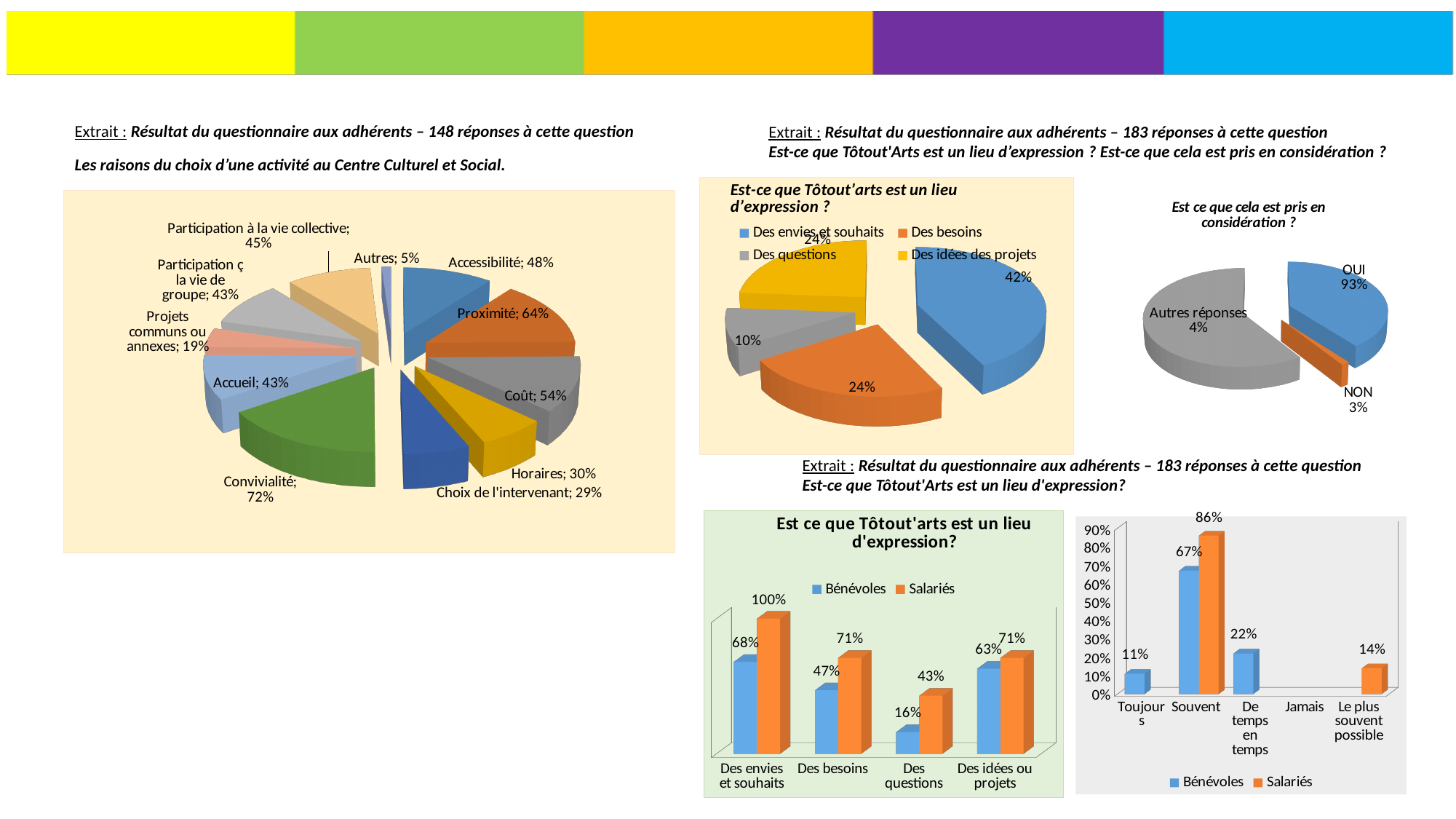
In the pie chart 'Est-ce que Tôtout'arts est un lieu d'expression ?' (top right, with legend), what is the share for Des questions? 10% In the pie chart 'Est ce que cela est pris en considération ?', what is the share for OUI? 93% In the pie chart 'Est ce que cela est pris en considération ?', which is larger, NON or Autres réponses? Autres réponses In the pie chart 'Les raisons du choix d'une activité au Centre Culturel et Social', what is the difference between Proximité and Coût? 10% What type of chart is the chart at the bottom right of the slide (Toujours, Souvent, ...)? bar chart In the bar chart 'Est ce que Tôtout'arts est un lieu d'expression?' (bottom, with Bénévoles and Salariés), what is the value for Salariés for Des envies et souhaits? 100% In the bar chart at the bottom right of the slide (Toujours, Souvent, ...), what is the value for Salariés for Souvent? 86% How many entries does the legend list in the pie chart 'Est-ce que Tôtout'arts est un lieu d'expression ?' (top right)? 4 In the pie chart 'Les raisons du choix d'une activité au Centre Culturel et Social', which category has the lowest value? Autres How many categories are shown in the pie chart 'Les raisons du choix d'une activité au Centre Culturel et Social'? 11 In the pie chart 'Les raisons du choix d'une activité au Centre Culturel et Social', what is the value for Convivialité? 72% In the bar chart 'Est ce que Tôtout'arts est un lieu d'expression?' (bottom, with Bénévoles and Salariés), what is the difference between Salariés and Bénévoles for Des questions? 27%